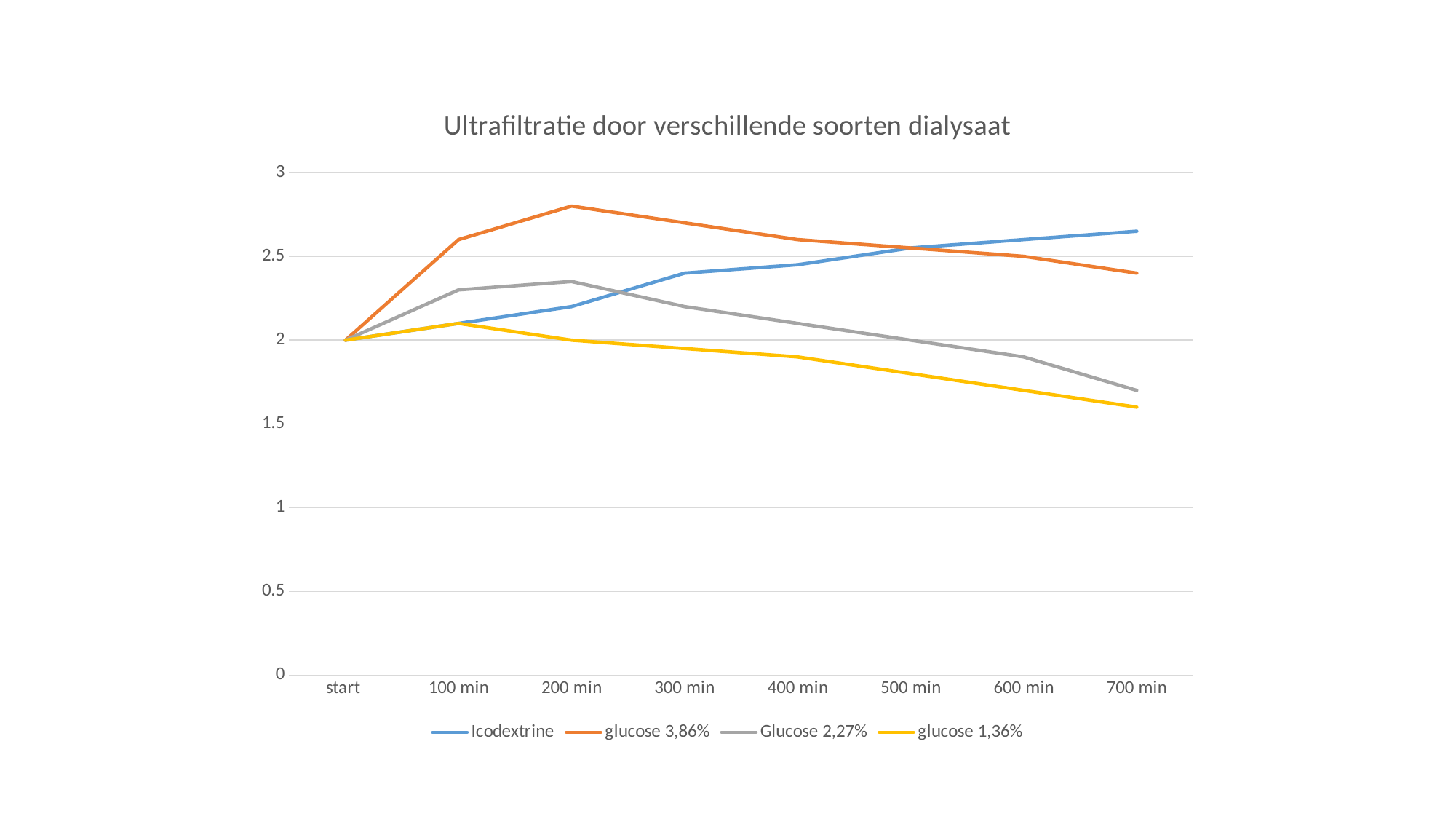
Is the value for Icodextrine at 700 min greater or less than 2.5? greater Which series has the highest value at 700 min? Icodextrine At 200 min, which is larger: glucose 3,86% or Glucose 2,27%? glucose 3,86% Is the value for glucose 3,86% at 200 min greater or less than 2.5? greater How many time points are shown along the x axis? 8 Which series has the lowest value at 700 min? glucose 1,36% What kind of chart is shown on the slide? line chart What is the title of the chart? Ultrafiltratie door verschillende soorten dialysaat Is the value for glucose 1,36% at 700 min greater or less than 2? less Does the glucose 1,36% line rise or fall from 100 min to 700 min? fall What is the value for Icodextrine at start? 2 How many series does the legend list? 4